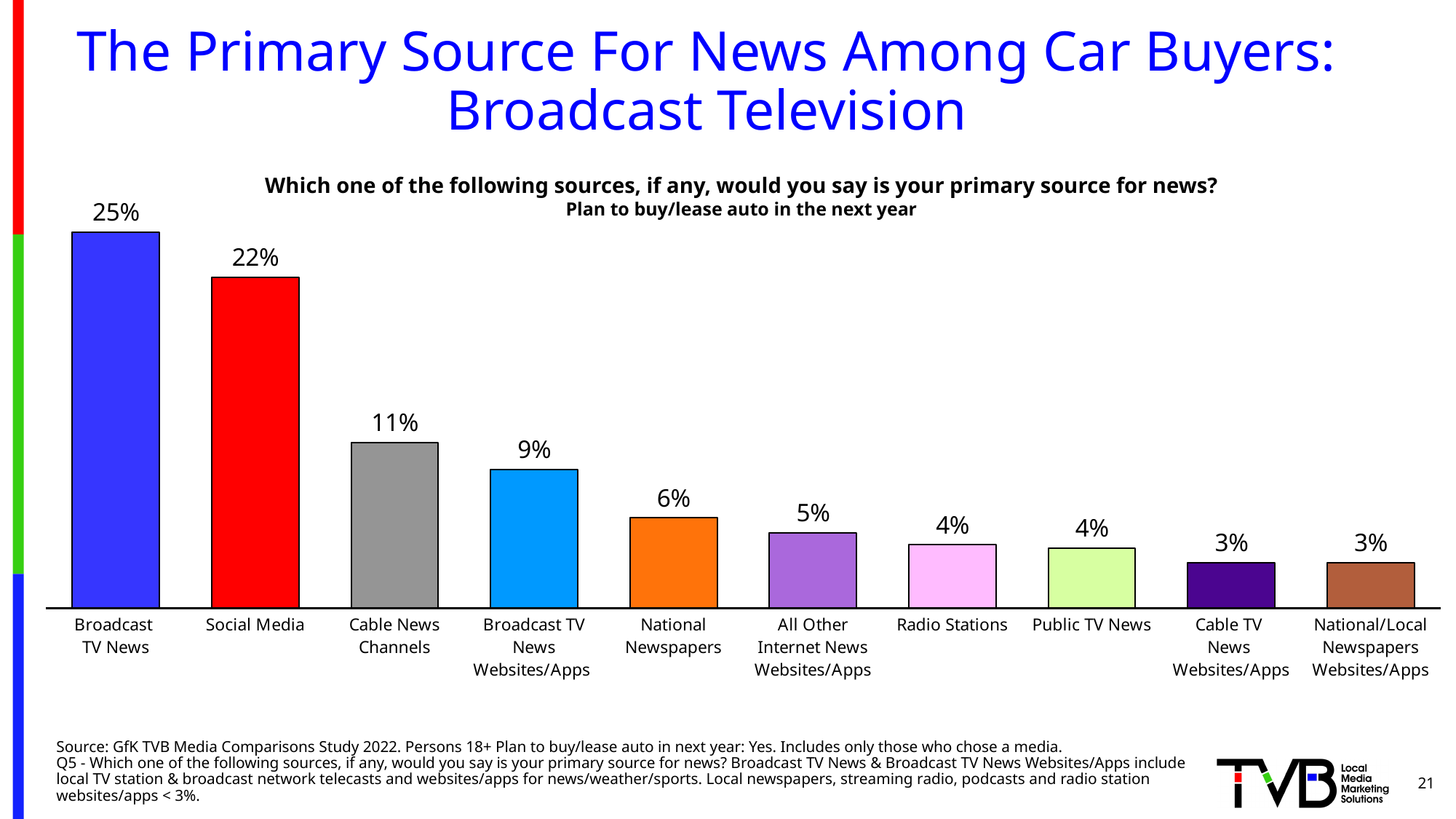
What percentage is shown for Cable News Channels? 11% What kind of chart is shown on the slide? Bar chart What colour is the bar for Social Media? Red What is the difference between the values for Broadcast TV News and Social Media? 3% Which is larger, the value for Social Media or the value for Cable News Channels? Social Media Which news source has the highest percentage? Broadcast TV News Do the values rise or fall moving from left to right across the categories? Fall How many news source categories are shown in the chart? 10 What is the value shown for Social Media? 22% What is the difference between Cable News Channels and Broadcast TV News Websites/Apps? 2% What percentage of car buyers say Broadcast TV News is their primary source for news? 25% What is the value for National Newspapers? 6%